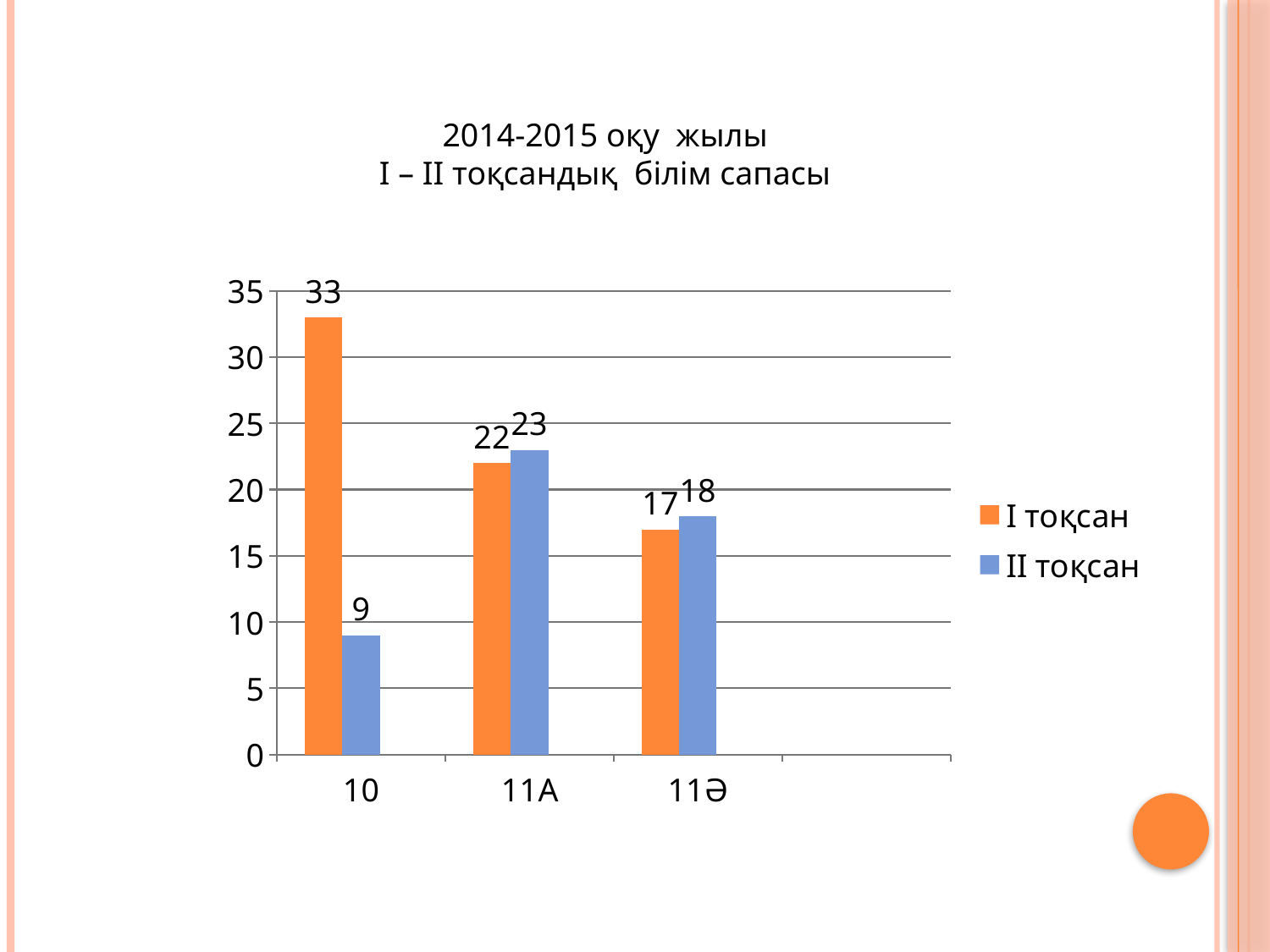
Which category has the highest I тоқсан value? 10 What is the value for I тоқсан for category 10? 33 What colour are the I тоқсан bars? Orange What kind of chart is shown on the slide? Bar chart What is the value for II тоқсан for category 10? 9 Which category has the lowest II тоқсан value? 10 Which is larger for category 11А: I тоқсан or II тоқсан? II тоқсан What is the value for II тоқсан for category 11А? 23 How many categories are shown on the x axis? 3 How many series does the legend list? 2 What is the difference between the I тоқсан and II тоқсан values for category 10? 24 What is the value for I тоқсан for category 11Ә? 17